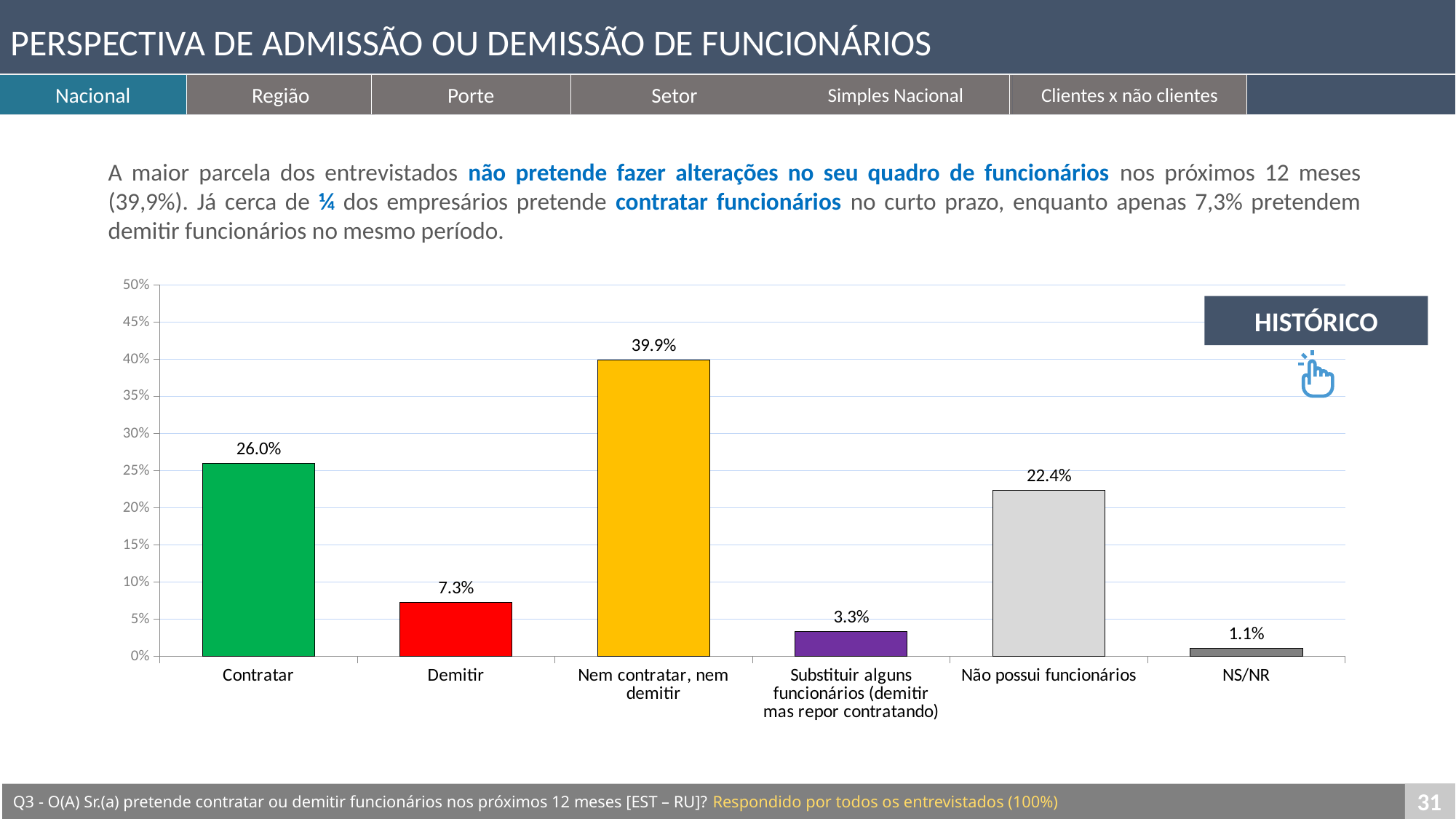
What is the value for Demitir? 7.3% Which category has the highest value? Nem contratar, nem demitir How many categories are shown on the chart? 6 What is the value for Contratar? 26.0% Is the value for Nem contratar, nem demitir greater or less than 35%? greater What colour is the bar for Nem contratar, nem demitir? Yellow Which category has the lowest value? NS/NR What is the value for NS/NR? 1.1% What is the difference between Contratar and Demitir? 18.7% Which is larger, Contratar or Não possui funcionários? Contratar What kind of chart is shown? Bar chart What is the value for Não possui funcionários? 22.4%